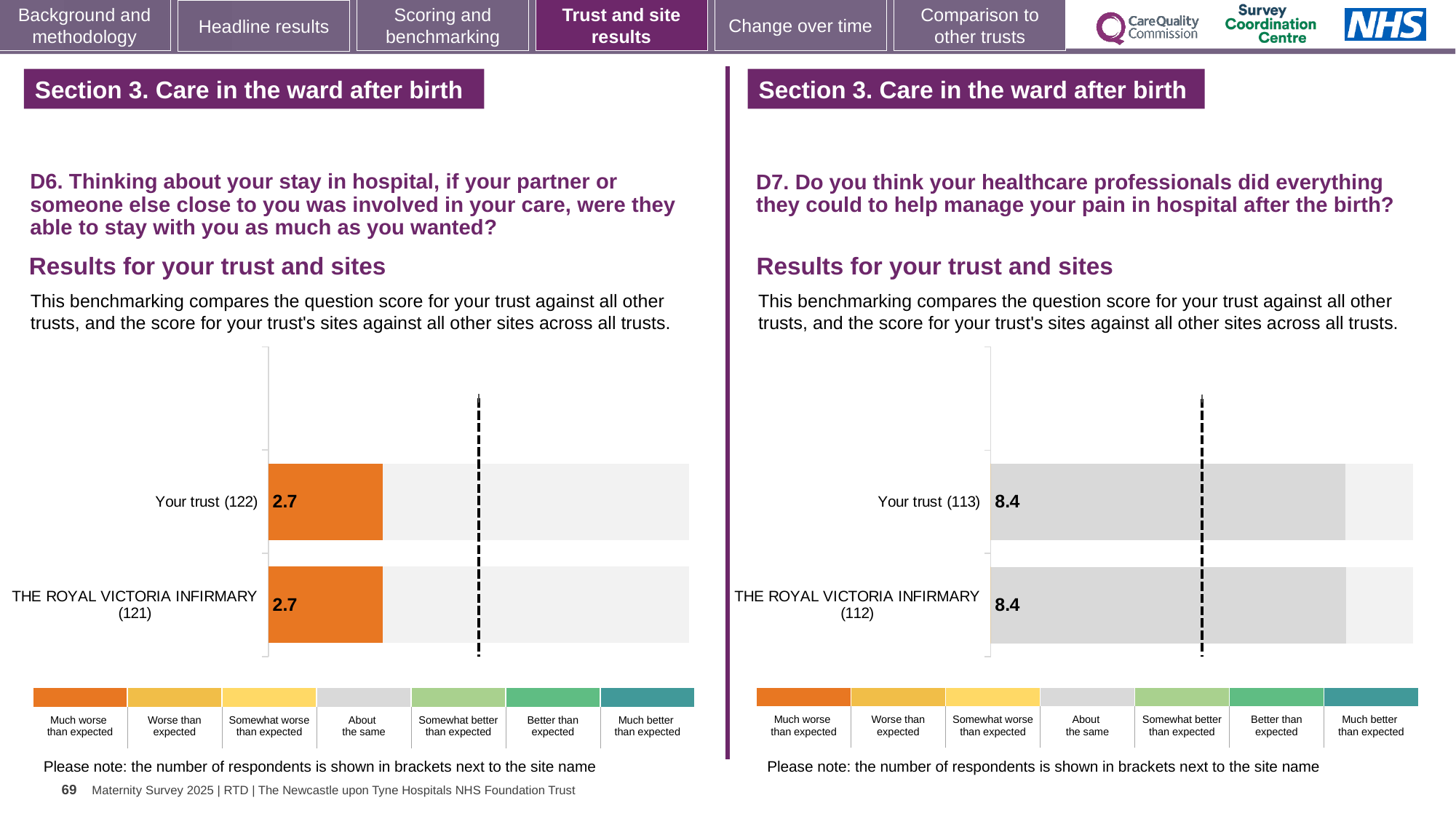
In the D6 chart on the left, how many respondents are shown in brackets for Your trust? 122 In the D6 chart on the left, what is the difference between the score for Your trust and the score for THE ROYAL VICTORIA INFIRMARY? 0.0 In the D7 chart on the right, what is the score for THE ROYAL VICTORIA INFIRMARY? 8.4 What kind of chart is used in the D6 chart on the left? Bar chart In the D6 chart on the left, what is the score for Your trust? 2.7 In the D6 chart on the left, what is the score for THE ROYAL VICTORIA INFIRMARY? 2.7 In the D7 chart on the right, what is the difference between the score for Your trust and the score for THE ROYAL VICTORIA INFIRMARY? 0.0 In the D7 chart on the right, what is the score for Your trust? 8.4 How many bars are plotted in the D7 chart on the right? 2 How many bars are plotted in the D6 chart on the left? 2 In the D7 chart on the right, how many respondents are shown in brackets for THE ROYAL VICTORIA INFIRMARY? 112 In the D6 chart on the left, which benchmark category does the orange colour of the bars correspond to in the legend? Much worse than expected